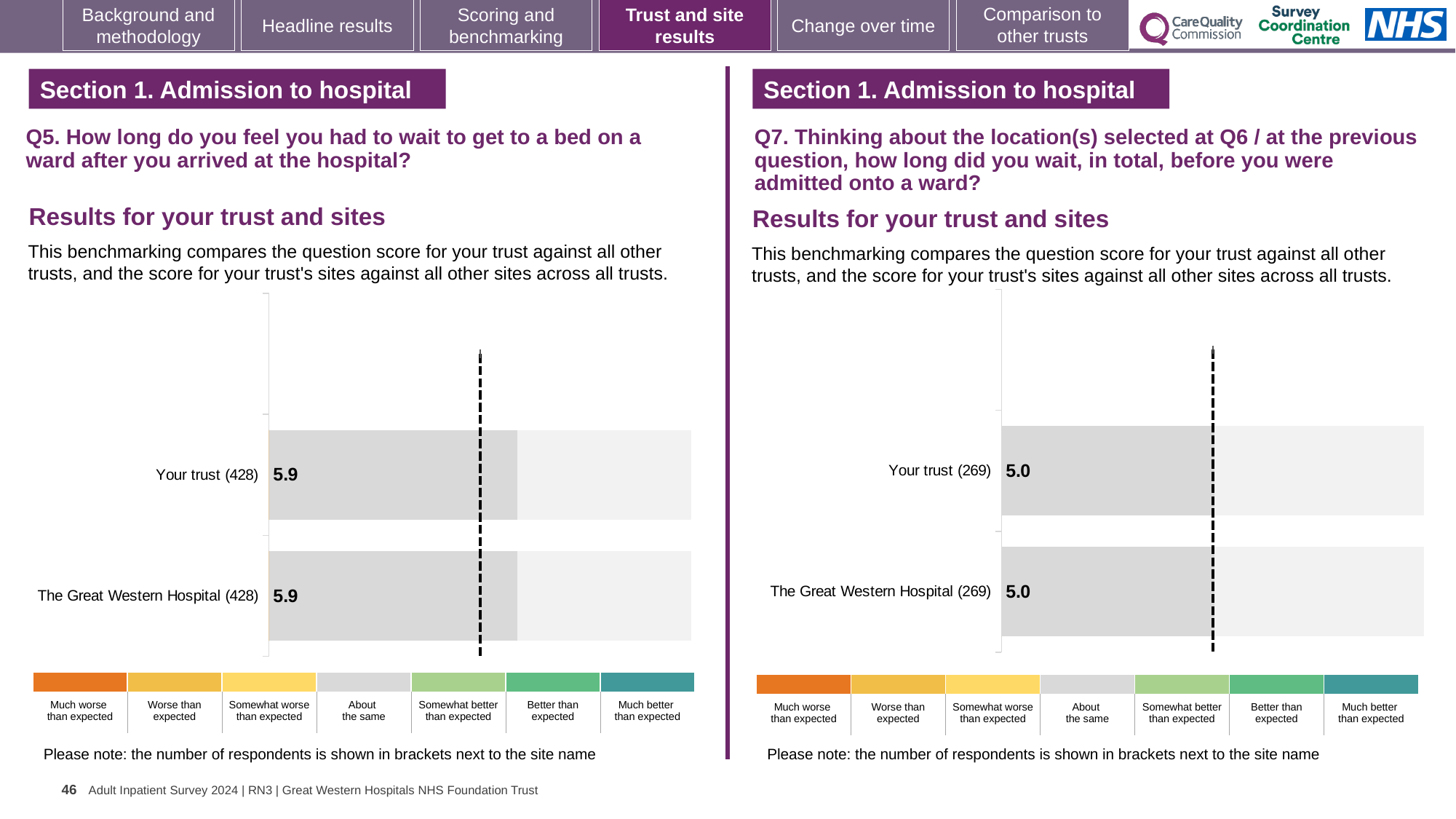
In the Q7 chart on the right, how many respondents are shown in brackets next to The Great Western Hospital? 269 In the Q5 chart on the left, what is the score for The Great Western Hospital? 5.9 In the Q5 chart on the left, how many respondents are shown in brackets next to Your trust? 428 In the Q7 chart on the right, what is the score for Your trust? 5.0 In the Q7 chart on the right, what is the score for The Great Western Hospital? 5.0 In the Q5 chart on the left, what is the score for Your trust? 5.9 In the Q7 chart on the right, what is the difference between the score for Your trust and the score for The Great Western Hospital? 0.0 How many bars are plotted in the Q7 chart on the right? 2 What kind of chart is used for the Q5 results on the left? Bar chart How many bars are plotted in the Q5 chart on the left? 2 Is the score for Your trust in the Q5 chart on the left larger than, smaller than, or equal to the score for Your trust in the Q7 chart on the right? Larger In the Q5 chart on the left, what is the difference between the score for Your trust and the score for The Great Western Hospital? 0.0